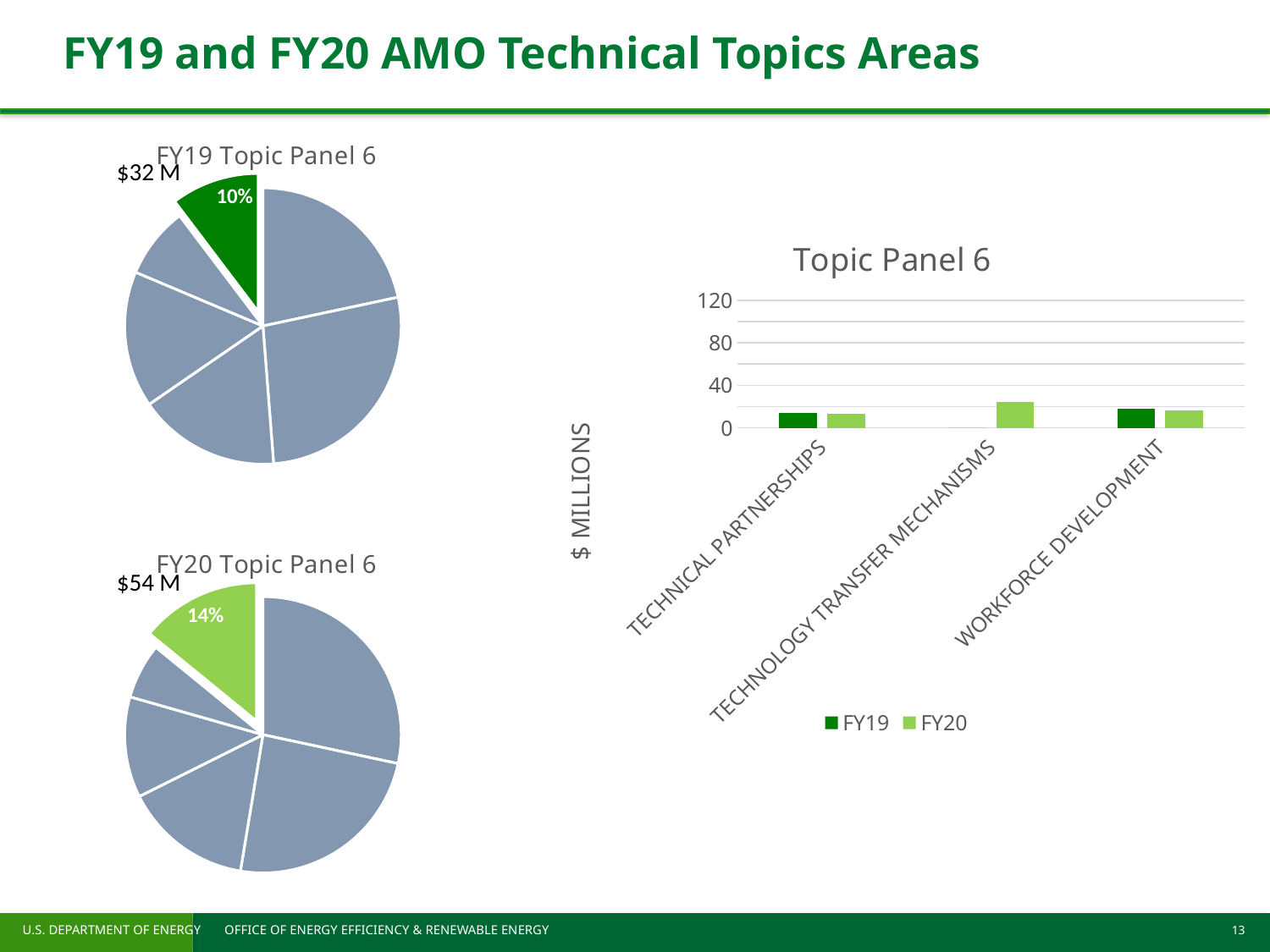
What kind of chart is the Topic Panel 6 chart on the right of the slide? bar chart What is the y-axis label of the Topic Panel 6 bar chart? $ MILLIONS In the Topic Panel 6 bar chart, how many series does the legend list? 2 What total dollar amount is printed next to the FY19 Topic Panel 6 pie chart? $32 M In the Topic Panel 6 bar chart, is the FY20 value for Technology Transfer Mechanisms greater or less than 40? less In the Topic Panel 6 bar chart, which category has the highest FY20 value? Technology Transfer Mechanisms In the Topic Panel 6 bar chart, what are the two legend entries? FY19 and FY20 In the Topic Panel 6 bar chart, how many categories are shown on the x axis? 3 In the FY20 Topic Panel 6 pie chart, what share of the pie does the highlighted green slice represent? 14% In the Topic Panel 6 bar chart, for Technology Transfer Mechanisms, which is larger: the FY19 value or the FY20 value? FY20 In the FY19 Topic Panel 6 pie chart, what share of the pie does the highlighted green slice represent? 10% What total dollar amount is printed next to the FY20 Topic Panel 6 pie chart? $54 M